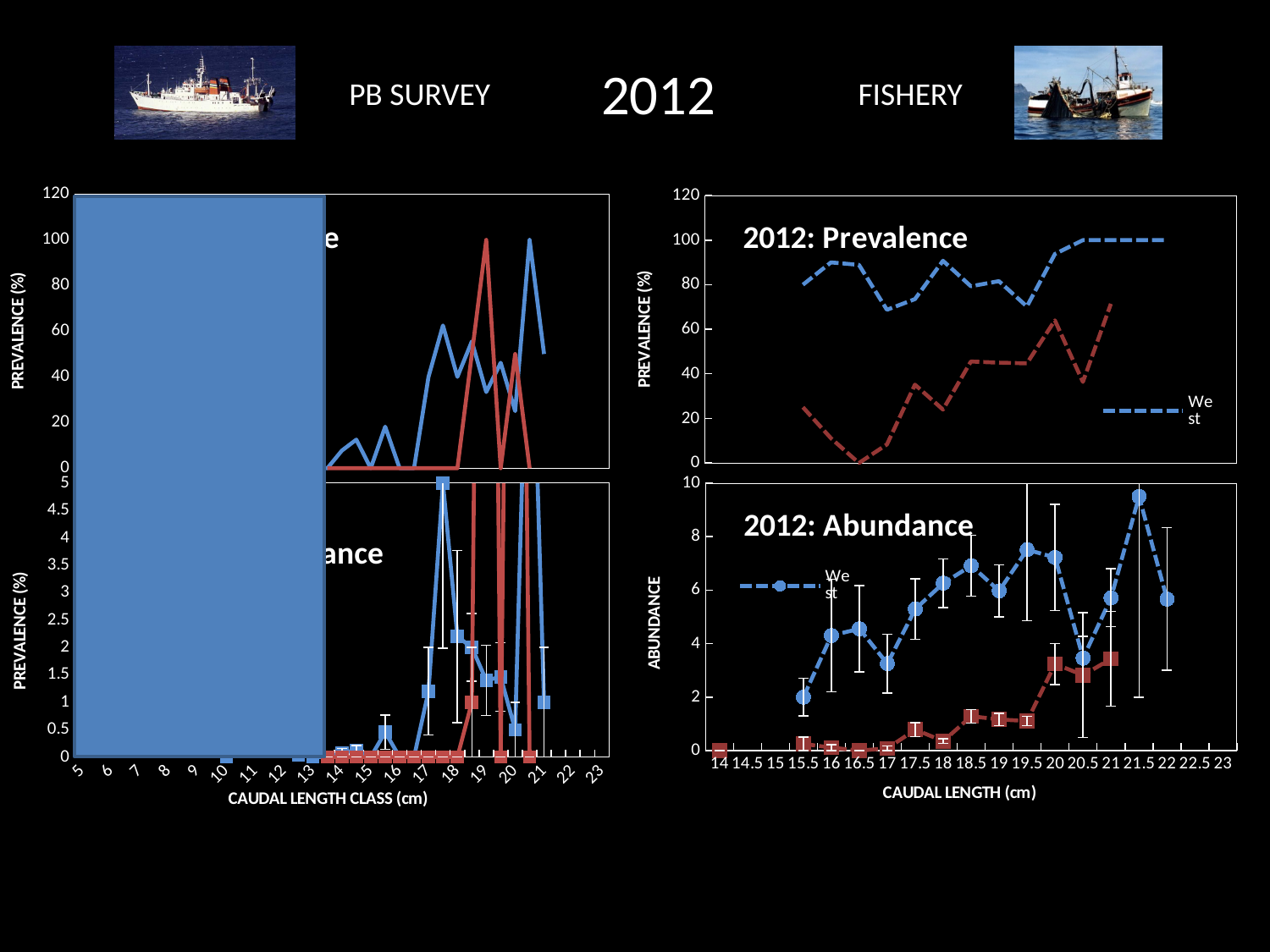
What kind of chart is the '2012: Abundance' chart on the right? line chart What kind of chart is the '2012: Prevalence' chart on the right? line chart In the '2012: Prevalence' chart, does the blue dashed line generally rise or fall from left to right? rise What is the x-axis title of the '2012: Abundance' chart? CAUDAL LENGTH (cm) In the '2012: Abundance' chart, is the value of the red square series at caudal length 18 greater or less than 2? less In the '2012: Prevalence' chart, is the value of the blue dashed line at its right-hand end greater or less than 80? greater In the '2012: Abundance' chart, is the value of the blue circle series at caudal length 21.5 greater or less than 8? greater In the '2012: Abundance' chart, at which caudal length does the blue circle series reach its highest value? 21.5 In the '2012: Abundance' chart, at caudal length 20, which series has the higher value, the blue circles or the red squares? blue circles What legend entry is shown in the '2012: Prevalence' chart? West In the '2012: Prevalence' chart, which line is higher across the x axis, the blue dashed line or the red dashed line? blue dashed line